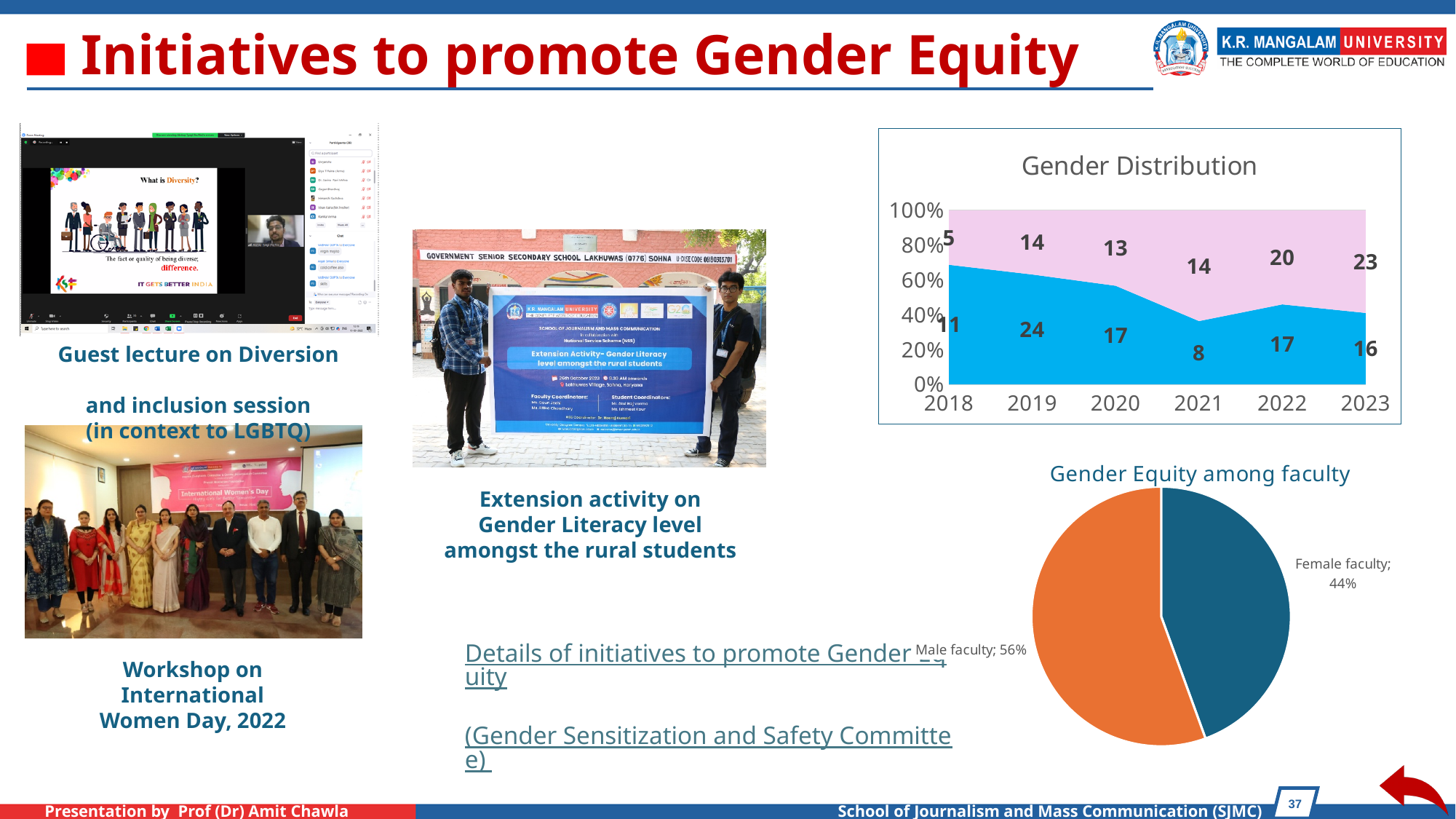
In the Gender Equity among faculty pie chart, which slice is larger, Male faculty or Female faculty? Male faculty In the Gender Distribution chart, which year has the lowest value for the blue (lower) series? 2021 In the Gender Distribution chart, what is the difference between the blue series value in 2019 and in 2021? 16 In the Gender Distribution chart, what is the total of the blue and pink values for 2022? 37 In the Gender Distribution chart, what is the value of the blue (lower) series for 2019? 24 In the Gender Distribution chart, what is the value of the pink (upper) series for 2023? 23 In the Gender Distribution chart, which year has the highest value for the pink (upper) series? 2023 How many years are shown on the x axis of the Gender Distribution chart? 6 In the Gender Distribution chart, what is the value of the blue (lower) series for 2021? 8 In the Gender Distribution chart, is the pink series value for 2020 larger or smaller than the blue series value for 2020? smaller In the Gender Equity among faculty pie chart, what share is Female faculty? 44% What kind of chart is the Gender Equity among faculty chart? Pie chart